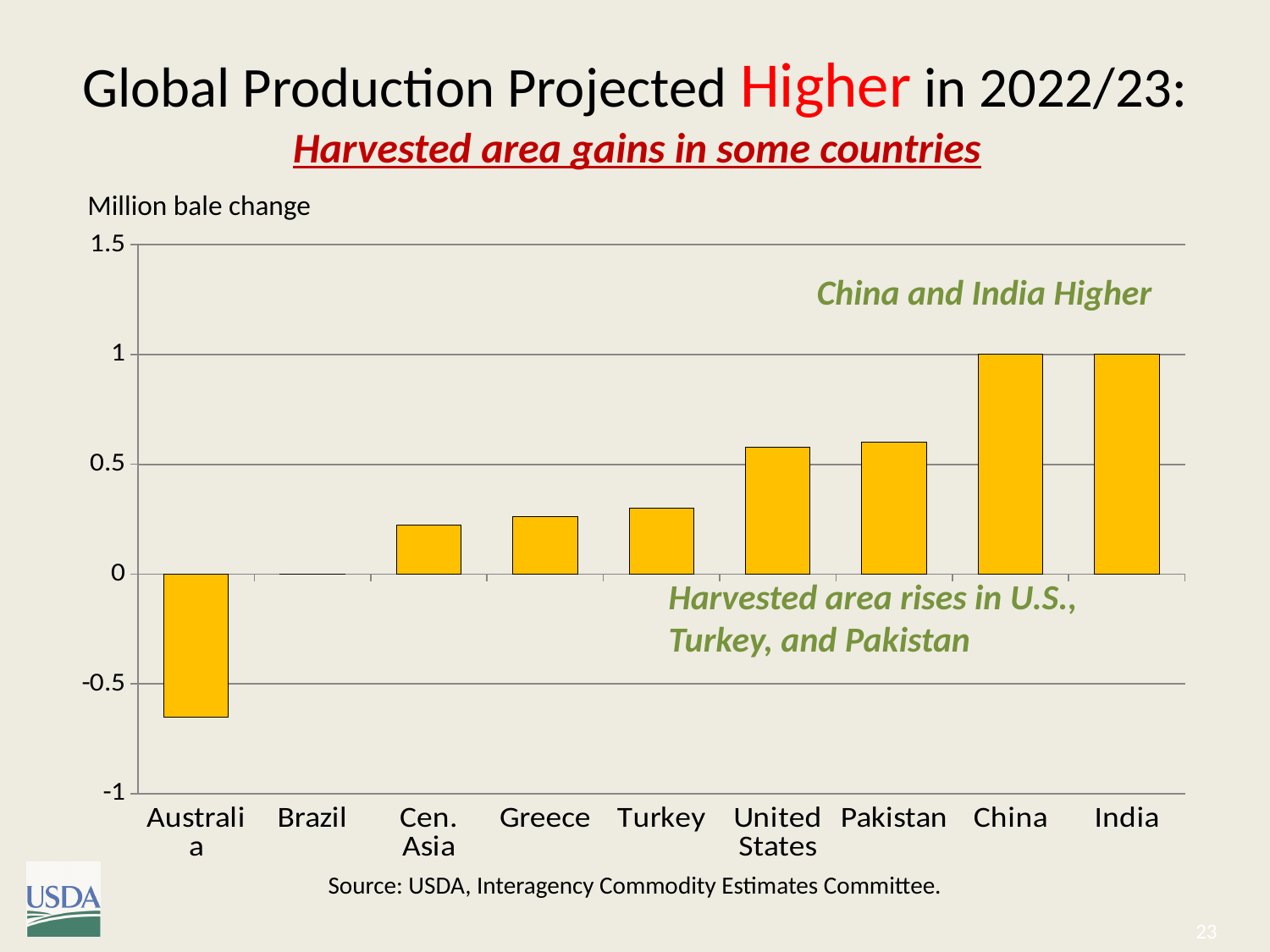
Is the value for Australia greater or less than -0.5? less Is the value for Turkey greater or less than 0.5? less What unit label is shown above the chart's vertical axis? Million bale change Is the value for Greece greater or less than 0? greater How many countries or regions are shown on the x axis of the chart? 9 What is the value for India in the chart? 1 Which has the larger value, Cen. Asia or Pakistan? Pakistan Which has the larger value, Turkey or United States? United States What kind of chart is shown on the slide? bar chart Which country has the lowest value in the chart? Australia What is the value for China in the chart? 1